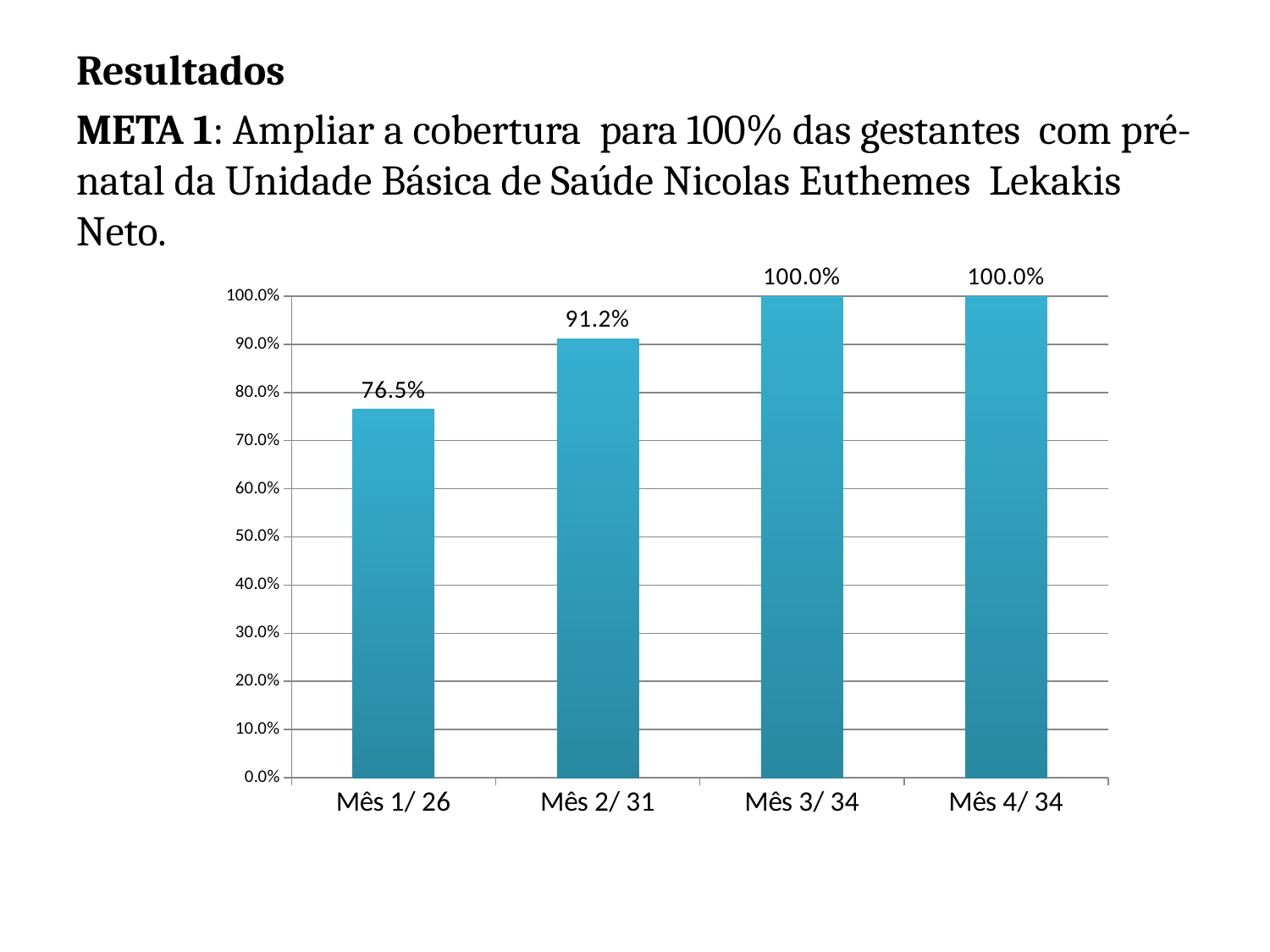
What is the value for Mês 2/ 31? 91.2% What is the value for Mês 3/ 34? 100.0% Do the values rise or fall from Mês 1/ 26 to Mês 4/ 34? rise What is the difference between the values for Mês 2/ 31 and Mês 1/ 26? 14.7% What is the value for Mês 4/ 34? 100.0% Which is larger, the value for Mês 1/ 26 or the value for Mês 2/ 31? Mês 2/ 31 Is the value for Mês 1/ 26 greater or less than 80.0%? less What is the value for Mês 1/ 26? 76.5% Which category has the lowest value? Mês 1/ 26 What is the difference between the values for Mês 3/ 34 and Mês 2/ 31? 8.8% What kind of chart is shown on the slide? bar chart How many categories are shown on the x axis? 4